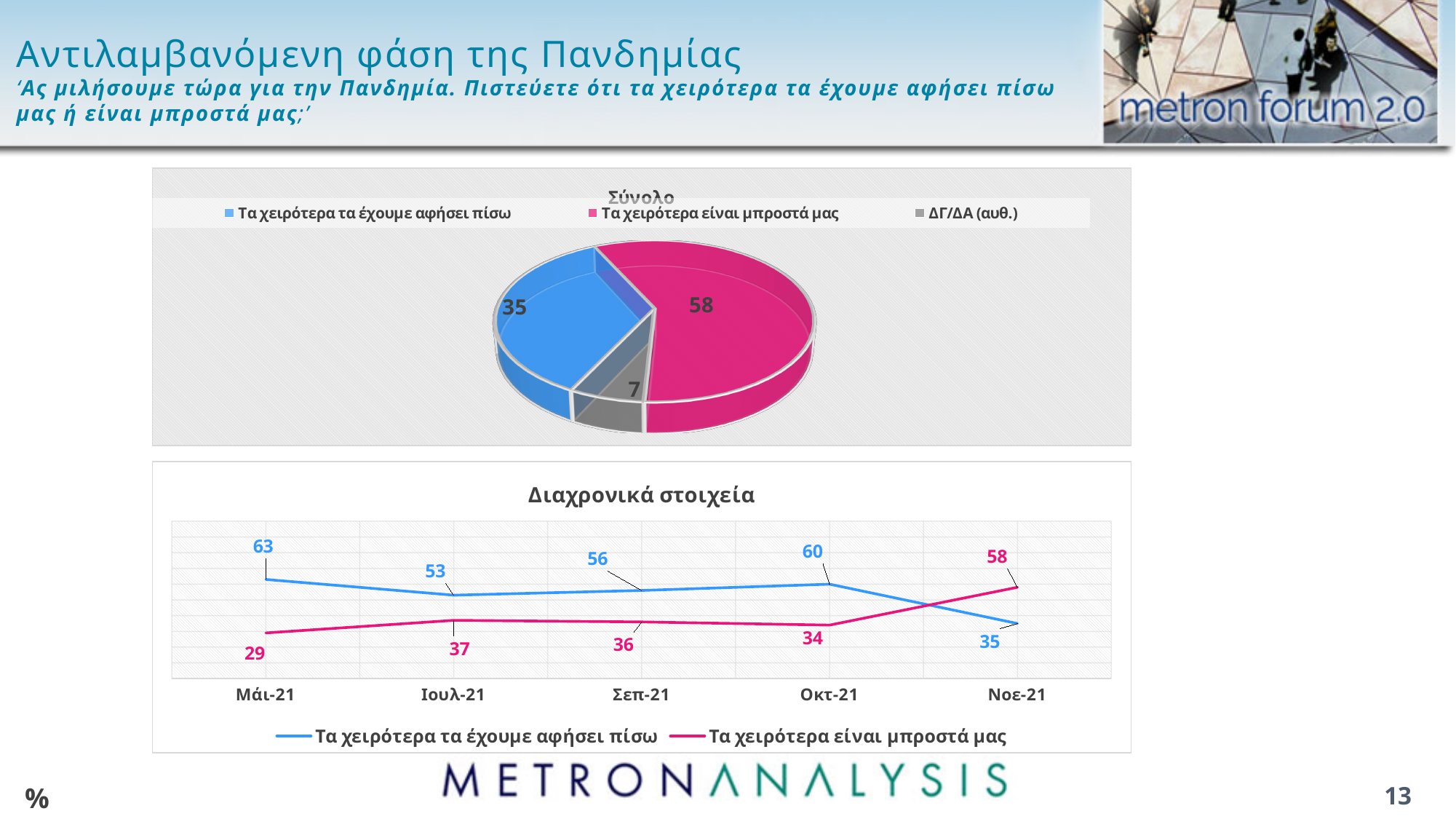
In the pie chart titled 'Σύνολο', which category has the smallest slice? ΔΓ/ΔΑ (αυθ.) In the pie chart titled 'Σύνολο', what is the value for 'ΔΓ/ΔΑ (αυθ.)'? 7 In the pie chart titled 'Σύνολο', what is the difference between 'Τα χειρότερα είναι μπροστά μας' and 'Τα χειρότερα τα έχουμε αφήσει πίσω'? 23 In the chart titled 'Διαχρονικά στοιχεία', which series has the higher value in Νοε-21? Τα χειρότερα είναι μπροστά μας In the pie chart titled 'Σύνολο', what is the value for 'Τα χειρότερα είναι μπροστά μας'? 58 In the chart titled 'Διαχρονικά στοιχεία', what is the value for 'Τα χειρότερα είναι μπροστά μας' in Οκτ-21? 34 In the pie chart titled 'Σύνολο', how many slices are there? 3 In the pie chart titled 'Σύνολο', which category has the largest slice? Τα χειρότερα είναι μπροστά μας In the chart titled 'Διαχρονικά στοιχεία', how many time points are shown on the x axis? 5 What kind of chart is the chart titled 'Διαχρονικά στοιχεία'? Line chart In the chart titled 'Διαχρονικά στοιχεία', how many series does the legend list? 2 In the chart titled 'Διαχρονικά στοιχεία', what is the value for 'Τα χειρότερα τα έχουμε αφήσει πίσω' in Μάι-21? 63